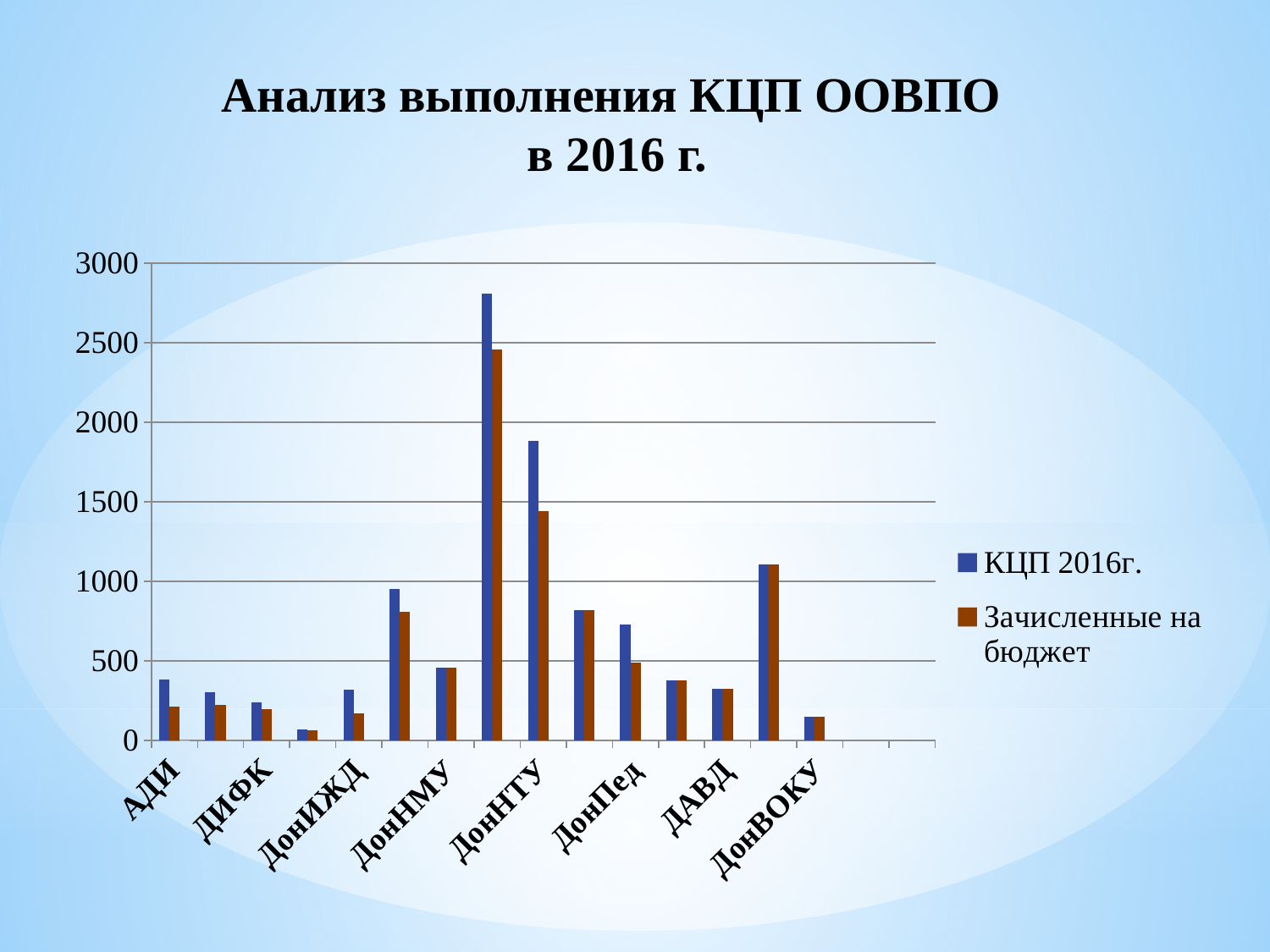
Is the КЦП 2016г. value for ДонИЖД greater or less than 500? less What is the title of the slide? Анализ выполнения КЦП ООВПО в 2016 г. Is the Зачисленные на бюджет value for ДонНТУ greater or less than 1000? greater For ДонНТУ, which series has the larger value, КЦП 2016г. or Зачисленные на бюджет? КЦП 2016г. How many series does the legend list? 2 Is the КЦП 2016г. value for АДИ greater or less than 500? less What kind of chart is shown on the slide? bar chart What are the two series named in the legend? КЦП 2016г. and Зачисленные на бюджет Which has the larger КЦП 2016г. value, ДонНТУ or ДАВД? ДонНТУ